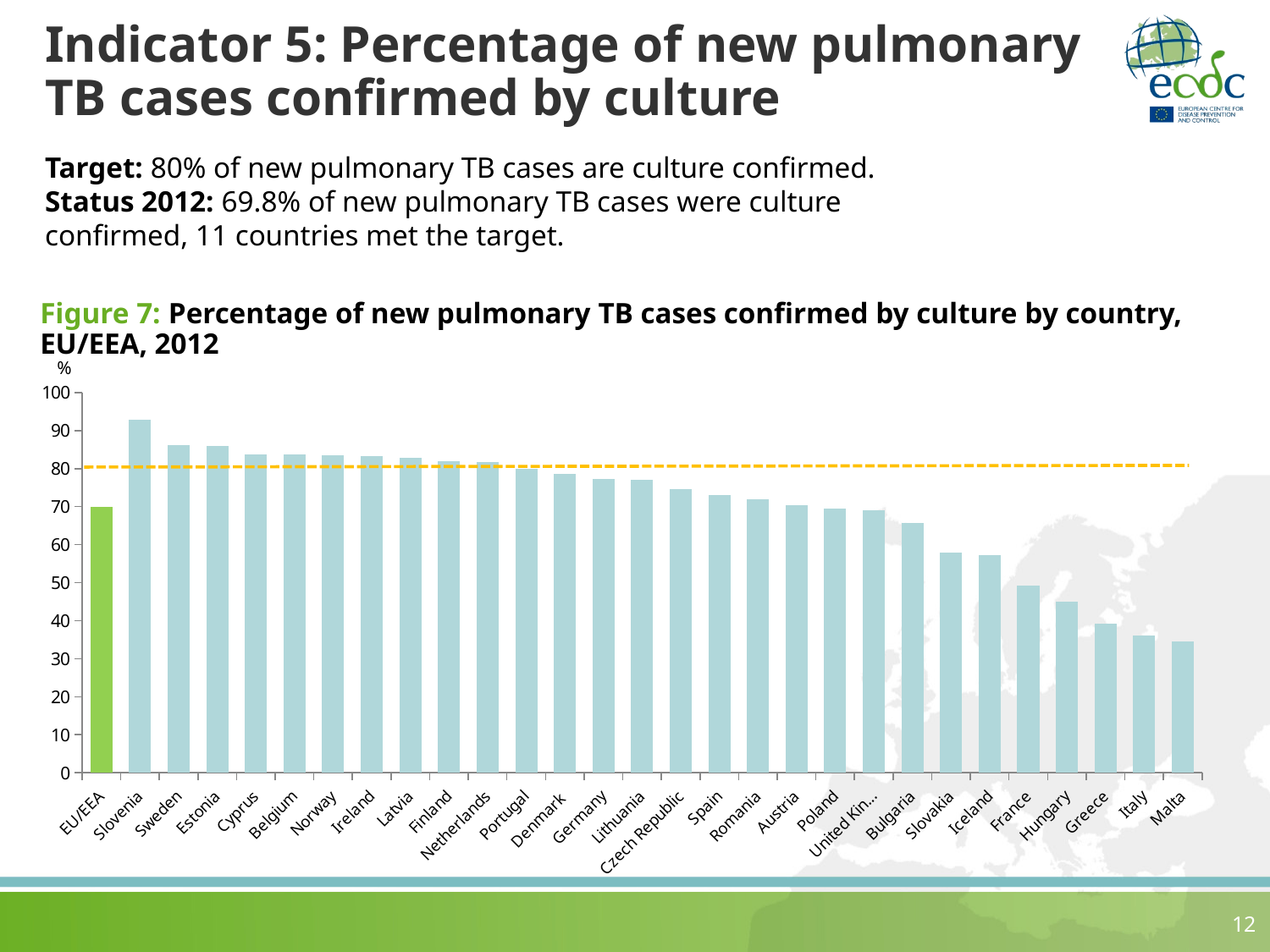
Is the value for Iceland greater or less than 50? greater Is the value for Slovenia greater or less than 90? greater At what percentage is the dashed horizontal target line drawn in Figure 7? 80 Moving from Slovenia on the left to Malta on the right, do the country values rise or fall? fall How many bars are plotted in Figure 7, including EU/EEA? 29 What kind of chart is shown in Figure 7? bar chart Is the value for Germany greater or less than 80? less Which country has the highest percentage of new pulmonary TB cases confirmed by culture in Figure 7? Slovenia Which has a higher percentage, Slovenia or Sweden? Slovenia Which country has the lowest percentage of new pulmonary TB cases confirmed by culture in Figure 7? Malta